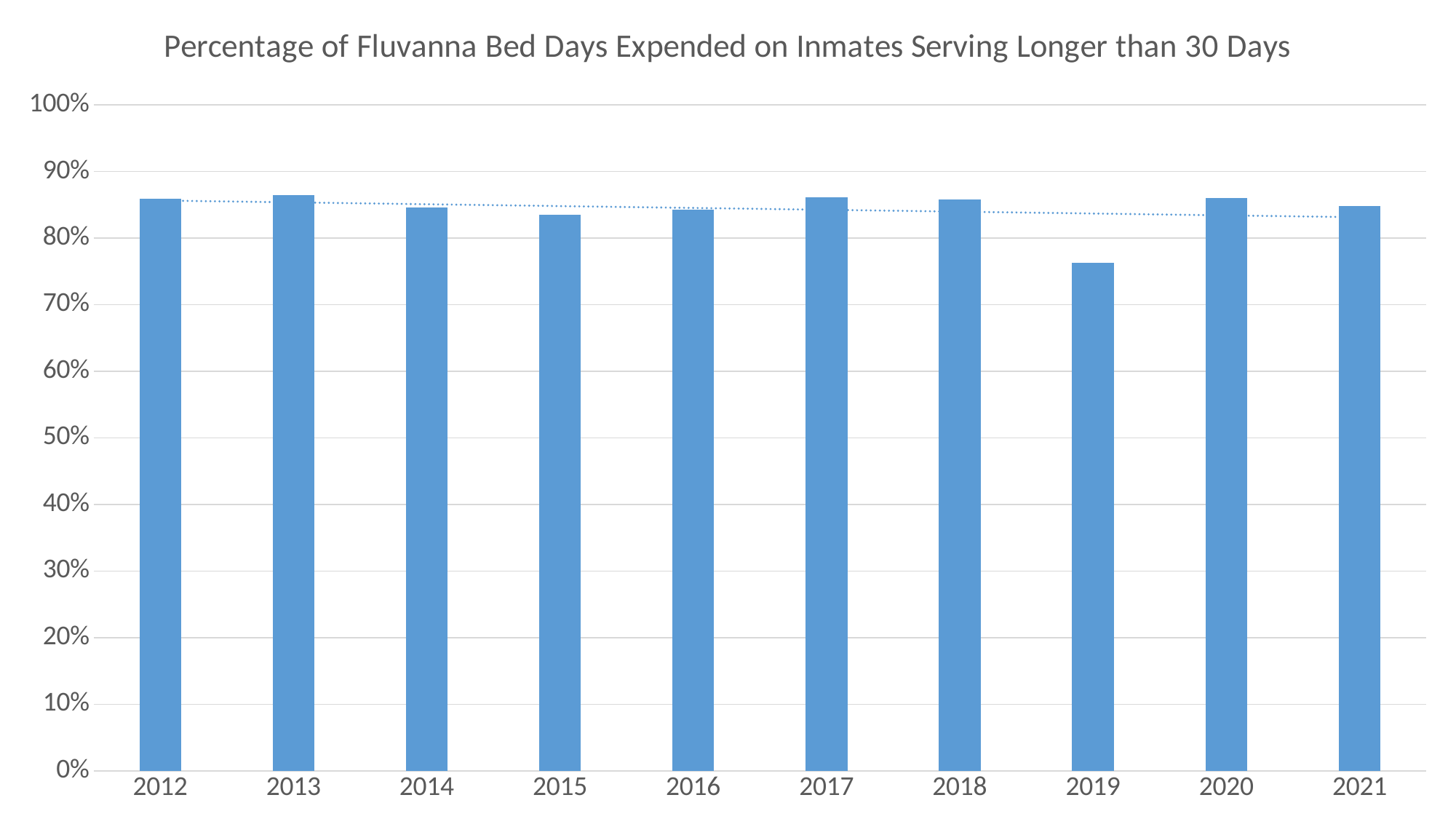
Does the dotted trend line rise or fall from 2012 to 2021? fall Which is larger, the value for 2019 or the value for 2020? 2020 Which is larger, the value for 2018 or the value for 2019? 2018 Which year has the lowest percentage of bed days expended on inmates serving longer than 30 days? 2019 Is the value for 2019 greater or less than 80%? less Is the value for 2019 greater or less than 70%? greater What kind of chart is shown on the slide? bar chart What is the first year shown on the x axis? 2012 Is the value for 2017 greater or less than 90%? less How many years are plotted on the chart? 10 What is the title of the chart? Percentage of Fluvanna Bed Days Expended on Inmates Serving Longer than 30 Days